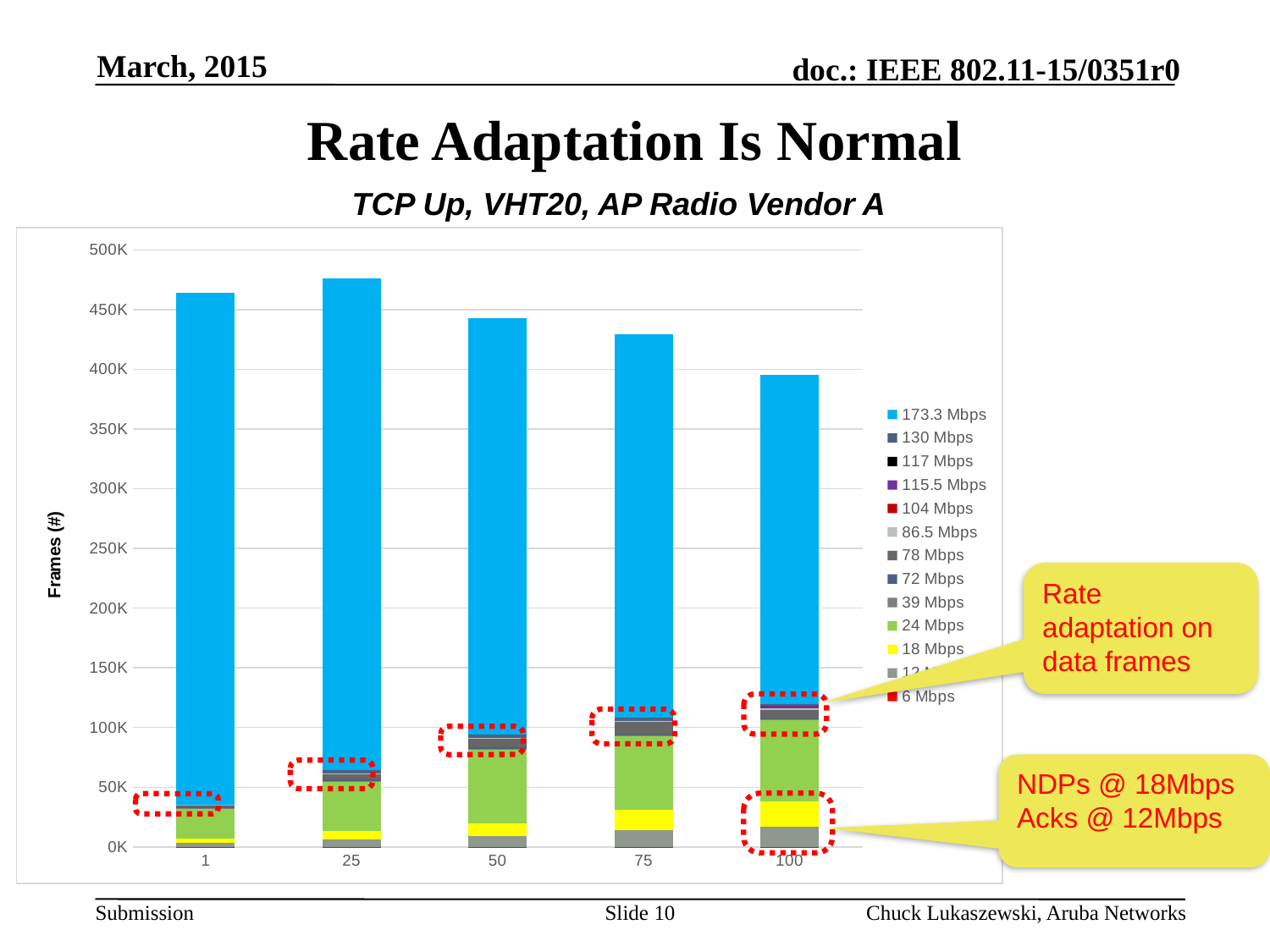
Is the total for category 100 greater or less than 450K? less Is the total for category 75 greater or less than 450K? less Which stacked bar is taller, category 1 or category 100? 1 Which x-axis category has the tallest stacked bar? 25 How many bars (x-axis categories) does the chart have? 5 What is the label of the y axis? Frames (#) Which x-axis category has the shortest stacked bar? 100 From category 25 to category 100, do the bar totals rise or fall? fall Is the total for category 25 greater or less than 450K? greater What kind of chart is shown on the slide? Stacked bar chart How many series does the legend list? 13 What is the title of the chart? TCP Up, VHT20, AP Radio Vendor A